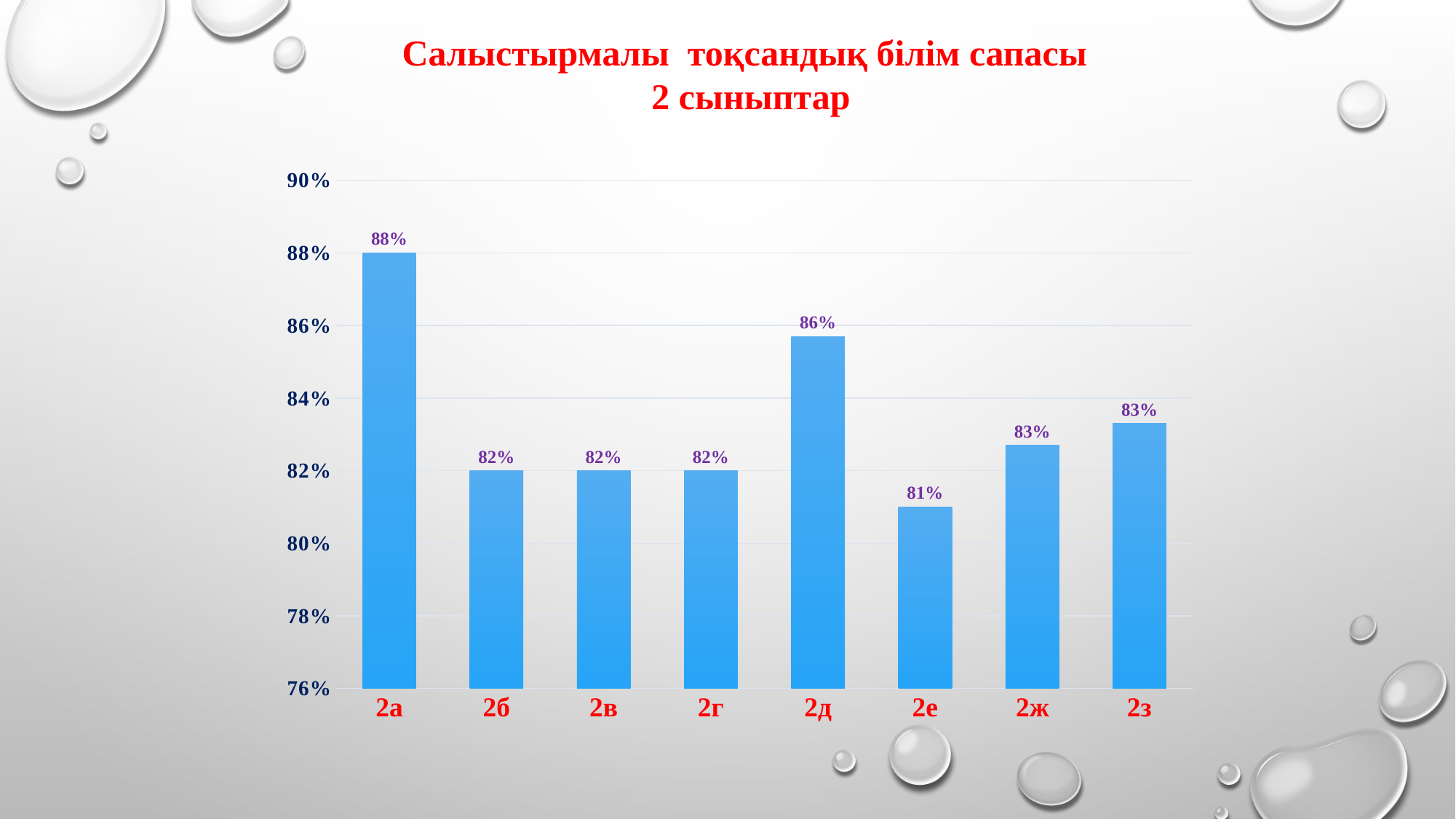
What is the difference between the values for 2а and 2е? 7% Which is larger, the value for 2д or the value for 2б? 2д What is the value for 2е? 81% Which category has the highest value? 2а What is the value for 2а? 88% What is the title of the chart? Салыстырмалы тоқсандық білім сапасы 2 сыныптар What is the value for 2ж? 83% What is the value for 2д? 86% Is the value for 2д greater or less than 84%? greater Which category has the lowest value? 2е What kind of chart is shown on the slide? bar chart How many categories are shown on the x axis? 8